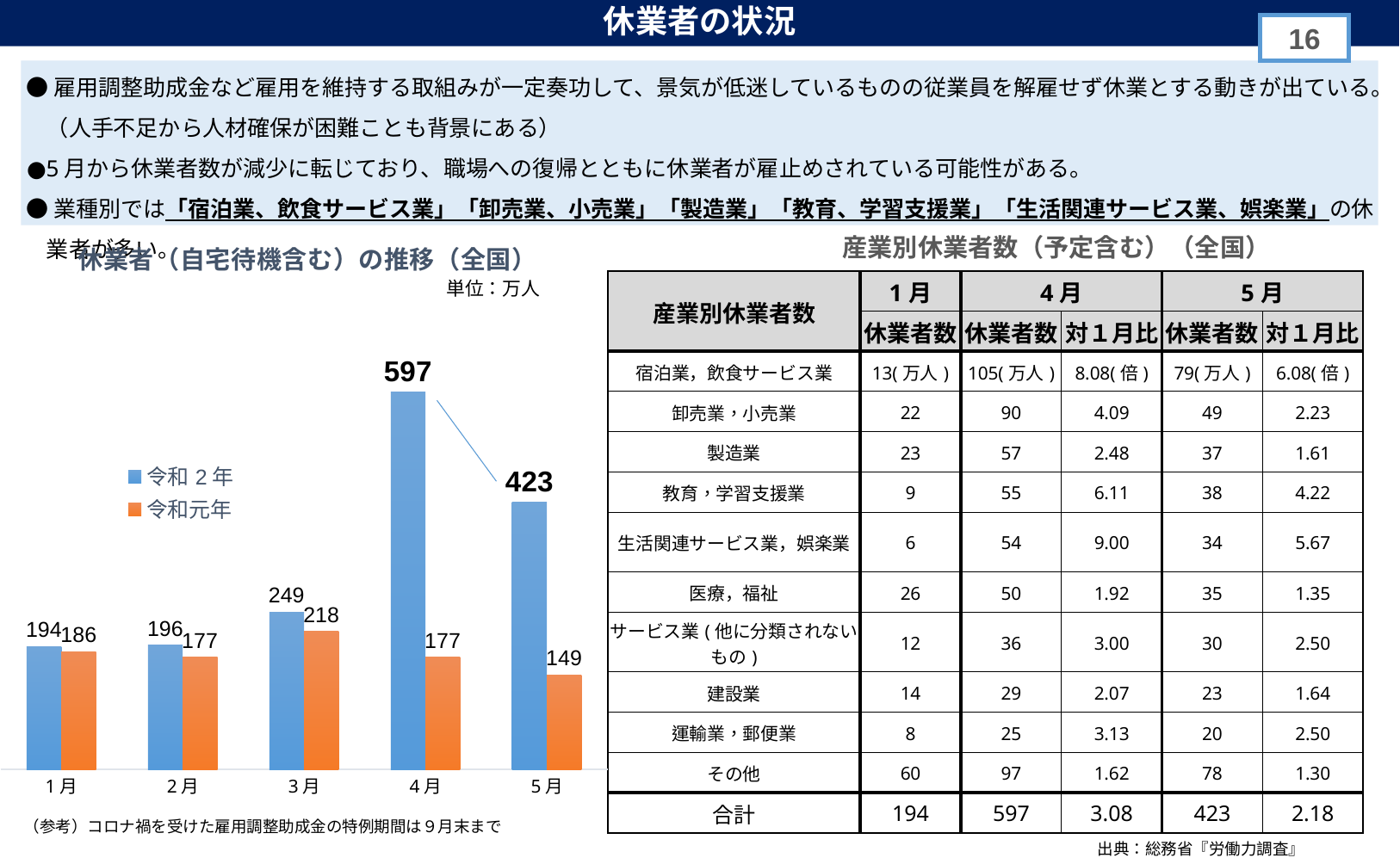
In the bar chart, what is the value for 令和元年 in 5月? 149 In the bar chart, which is larger in 1月: the 令和２年 value or the 令和元年 value? 令和２年 How many series does the legend of the bar chart list? 2 In the bar chart, what is the value for 令和２年 in 4月? 597 How many months are shown on the x axis of the bar chart? 5 What unit is stated for the values in the bar chart? 万人 In the bar chart, which month has the lowest value for 令和元年? 5月 In the bar chart, what is the difference between the 令和２年 values for 4月 and 5月? 174 In the bar chart, what is the value for 令和２年 in 3月? 249 In the bar chart, what is the difference between the 令和２年 and 令和元年 values in 4月? 420 In the bar chart, which month has the highest value for 令和２年? 4月 What type of chart is shown on the left of the slide? bar chart